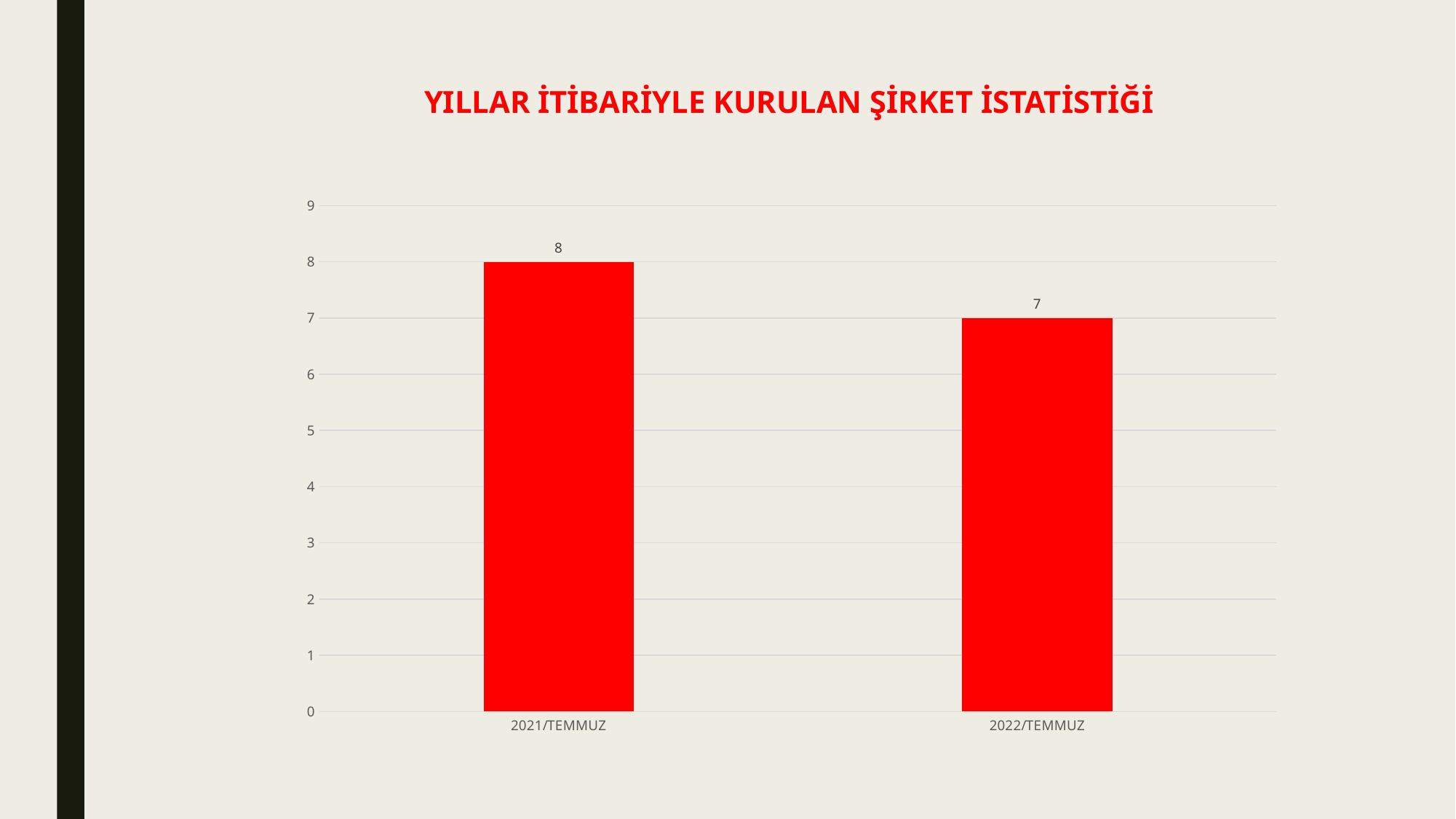
What is the difference between the values for 2021/TEMMUZ and 2022/TEMMUZ? 1 How many categories are shown on the x axis? 2 What is the value for 2022/TEMMUZ? 7 What is the value for 2021/TEMMUZ? 8 What is the title of the chart? YILLAR İTİBARİYLE KURULAN ŞİRKET İSTATİSTİĞİ Do the values rise or fall from 2021/TEMMUZ to 2022/TEMMUZ? fall Which category has the highest value? 2021/TEMMUZ What kind of chart is shown on the slide? bar chart Which category has the lowest value? 2022/TEMMUZ Which is larger, the value for 2021/TEMMUZ or the value for 2022/TEMMUZ? 2021/TEMMUZ What colour are the bars in the chart? red Is the value for 2022/TEMMUZ greater or less than 5? greater